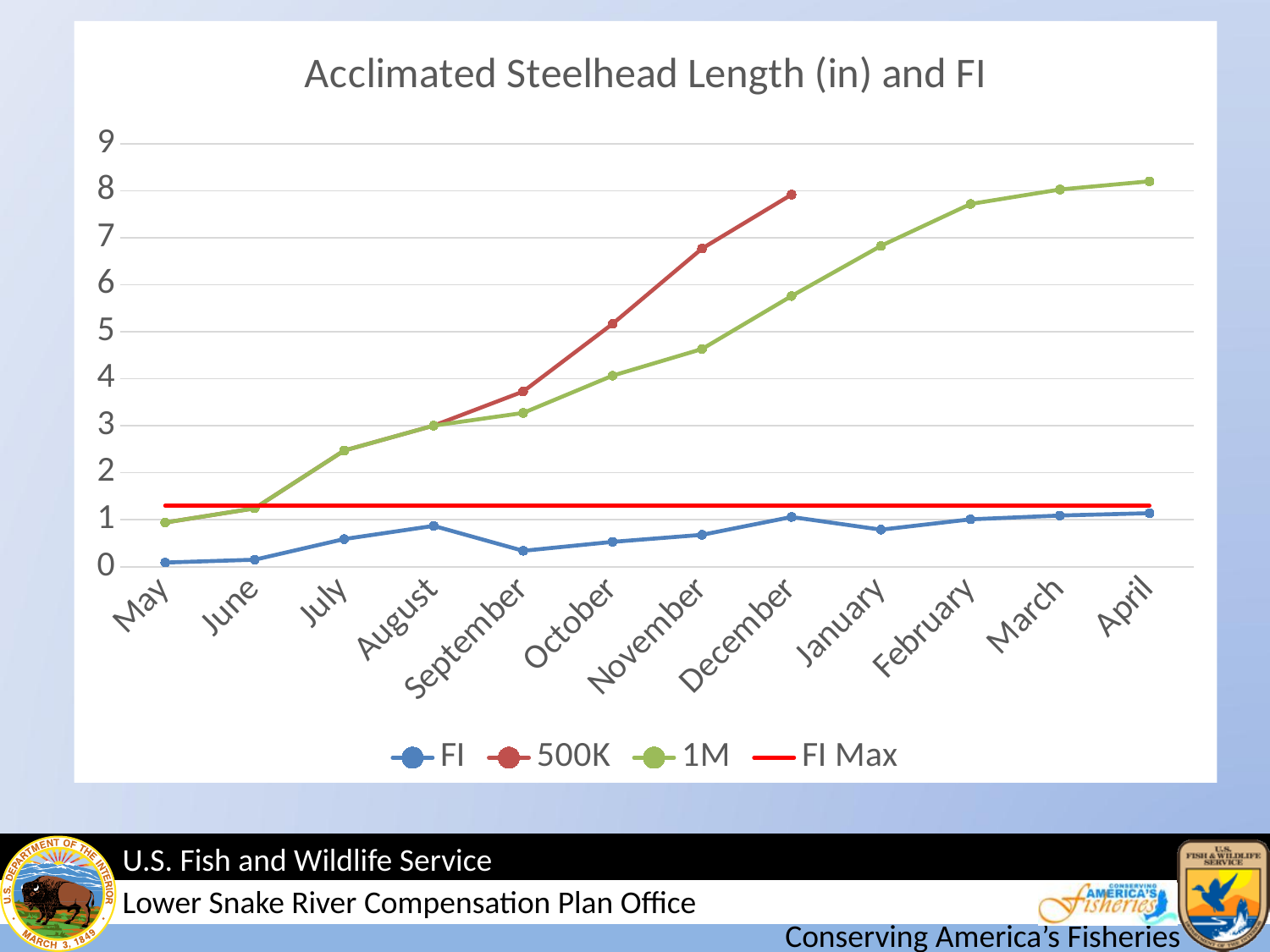
What kind of chart is shown on the slide? line chart What is the title of the chart? Acclimated Steelhead Length (in) and FI How many series does the legend list? 4 Is the value for the FI series in May greater or less than 1? less Is the value for the 500K series in November greater or less than 6? greater How many months are shown along the x axis? 12 Which series is drawn as a flat red line without markers? FI Max Does the 1M series rise or fall from May to April? rise In which month does the 1M series reach its highest value? April In December, which series has the larger value, 500K or 1M? 500K Is the value for the 1M series in July greater or less than 2? greater